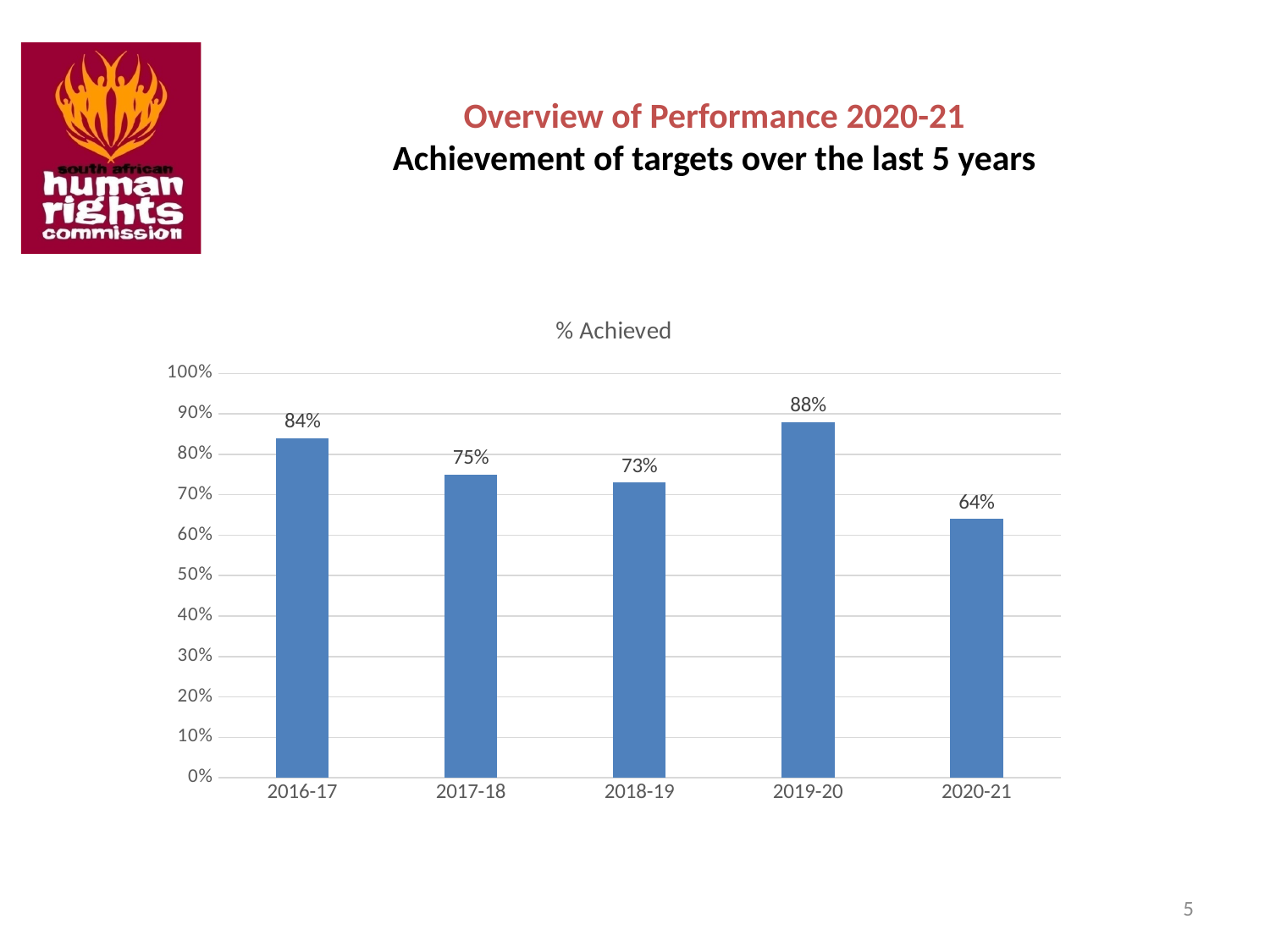
What is the difference in % Achieved between 2016-17 and 2017-18? 9% Is the value for 2018-19 greater or less than 80%? less What is the % Achieved value for 2020-21? 64% What is the difference in % Achieved between 2019-20 and 2020-21? 24% Which year has the lowest % Achieved? 2020-21 What is the title of the chart? % Achieved How many years are shown on the chart? 5 Which year has the highest % Achieved? 2019-20 What is the % Achieved value for 2019-20? 88% What kind of chart is shown on the slide? bar chart Which year has a higher % Achieved, 2017-18 or 2018-19? 2017-18 What is the % Achieved value for 2016-17? 84%